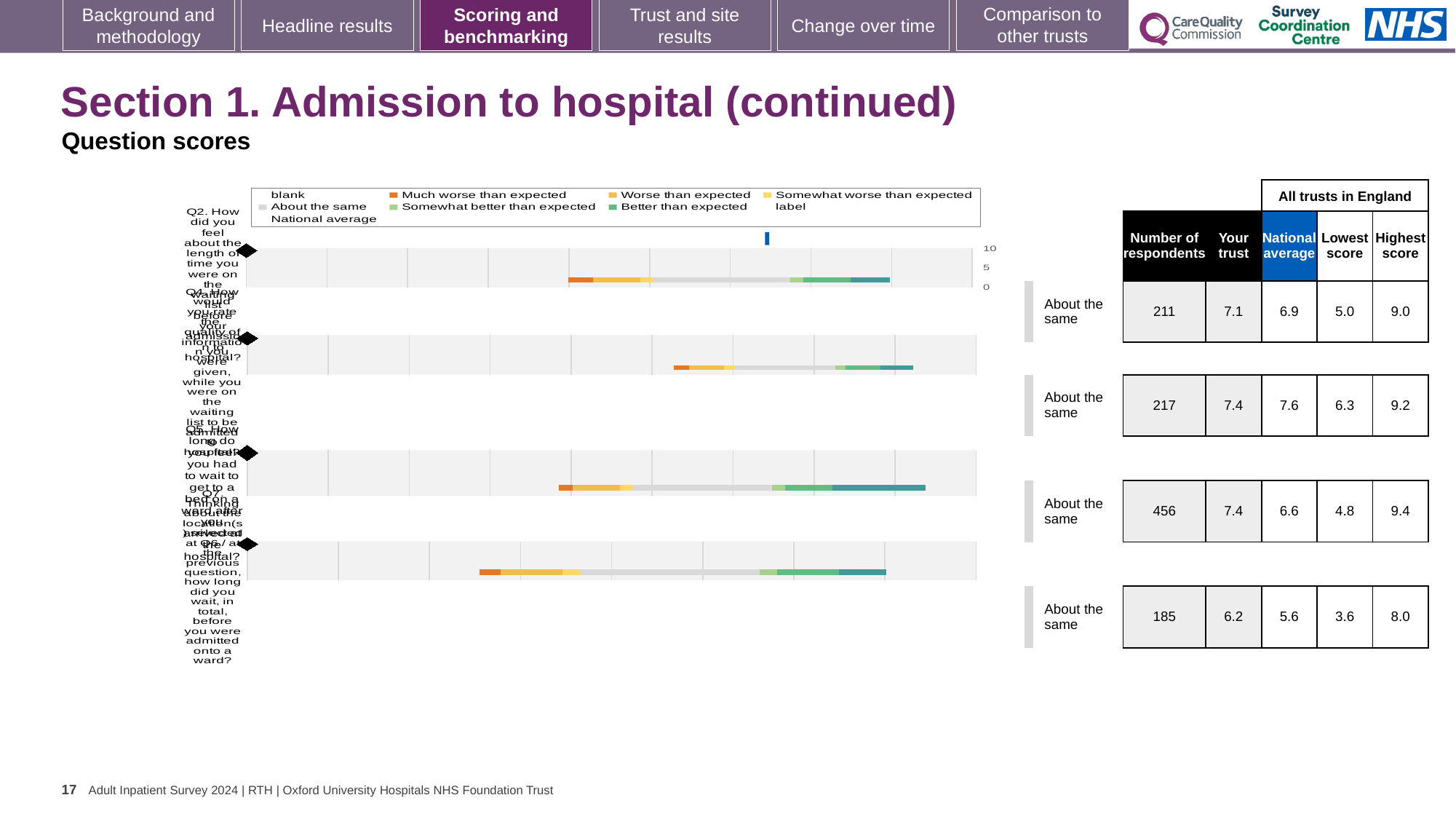
What colour is the 'Better than expected' band in the chart legend? Green What benchmark label is shown next to each of the four chart rows? About the same In the table beside the chart, what is the 'Your trust' score for the row with 211 respondents? 7.1 How many question rows (bars) are plotted in the chart? 4 In the table beside the chart, which row has the highest number of respondents? 456 In the table beside the chart, what is the difference between the highest score and the lowest score for the row with 456 respondents? 4.6 In the table beside the chart, what is the national average for the row with 185 respondents? 5.6 In the table beside the chart, what is the lowest 'Your trust' score shown? 6.2 What colour is the 'Much worse than expected' band in the chart legend? Orange What is the maximum value shown on the chart's score axis? 10 What kind of chart is shown on the slide? Bar chart In the table beside the chart, for the row with 211 respondents, which is larger: the 'Your trust' score or the 'National average'? Your trust